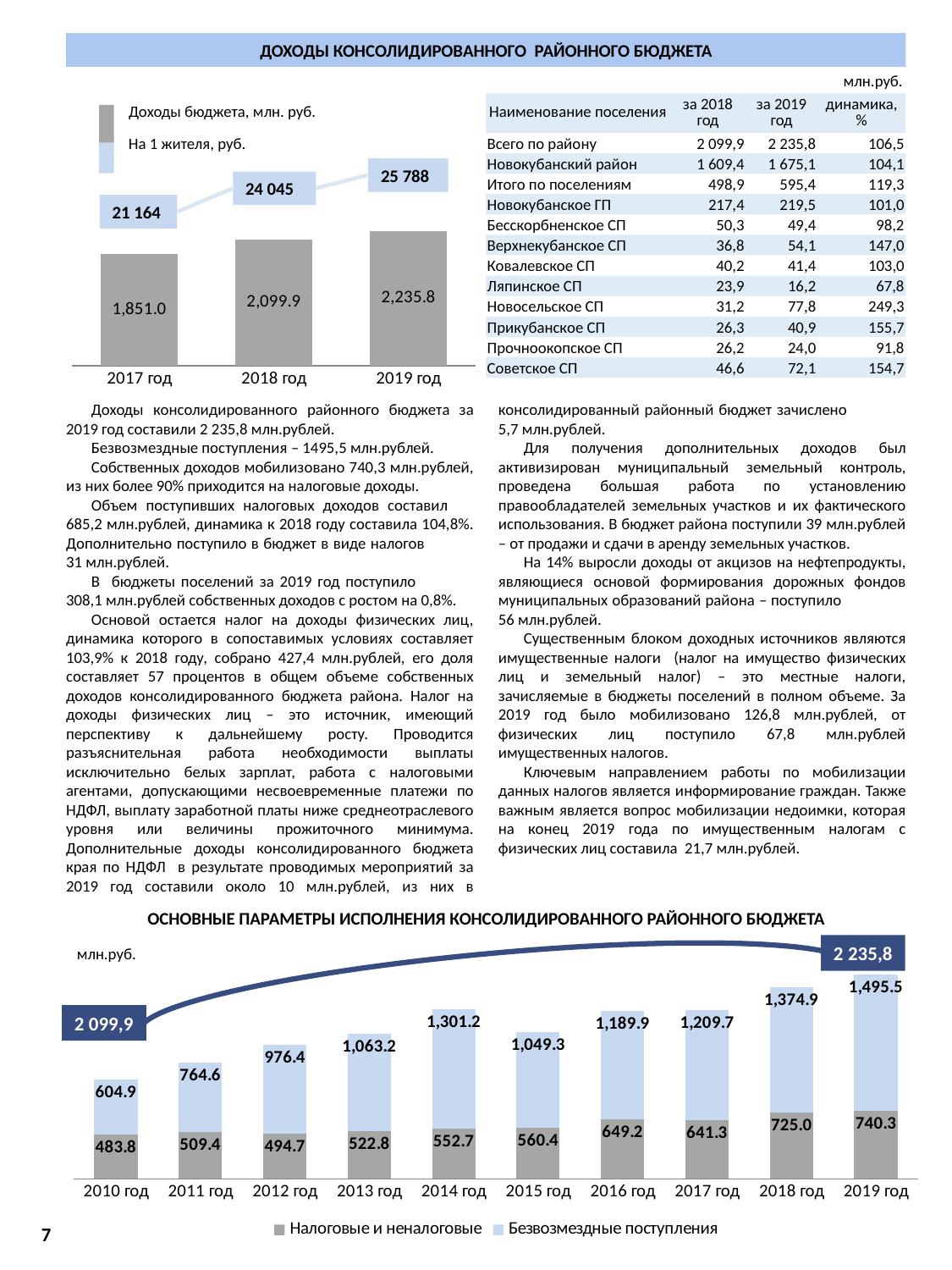
In the bottom chart 'Основные параметры исполнения консолидированного районного бюджета', which is larger: 'Безвозмездные поступления' for 2014 год or for 2015 год? 2014 год In the bottom chart 'Основные параметры исполнения консолидированного районного бюджета', what is the value of 'Безвозмездные поступления' for 2014 год? 1,301.2 In the top-left chart, what is the difference between 'Доходы бюджета, млн. руб.' for 2019 год and 2018 год? 135.9 In the top-left chart, do the values of 'На 1 жителя, руб.' rise or fall from 2017 год to 2019 год? rise In the bottom chart 'Основные параметры исполнения консолидированного районного бюджета', what is the value of 'Налоговые и неналоговые' for 2016 год? 649.2 In the bottom chart 'Основные параметры исполнения консолидированного районного бюджета', which year has the highest value of 'Безвозмездные поступления'? 2019 год In the bottom chart 'Основные параметры исполнения консолидированного районного бюджета', what is the total of the stacked bar for 2010 год? 1,088.7 In the top-left chart, what is the value of 'Доходы бюджета, млн. руб.' for 2019 год? 2,235.8 In the bottom chart 'Основные параметры исполнения консолидированного районного бюджета', how many series does the legend list? 2 In the top-left chart, what is the value of 'На 1 жителя, руб.' for 2017 год? 21 164 In the bottom chart 'Основные параметры исполнения консолидированного районного бюджета', how many years are shown on the x axis? 10 In the top-left chart, which year has the lowest value of 'Доходы бюджета, млн. руб.'? 2017 год